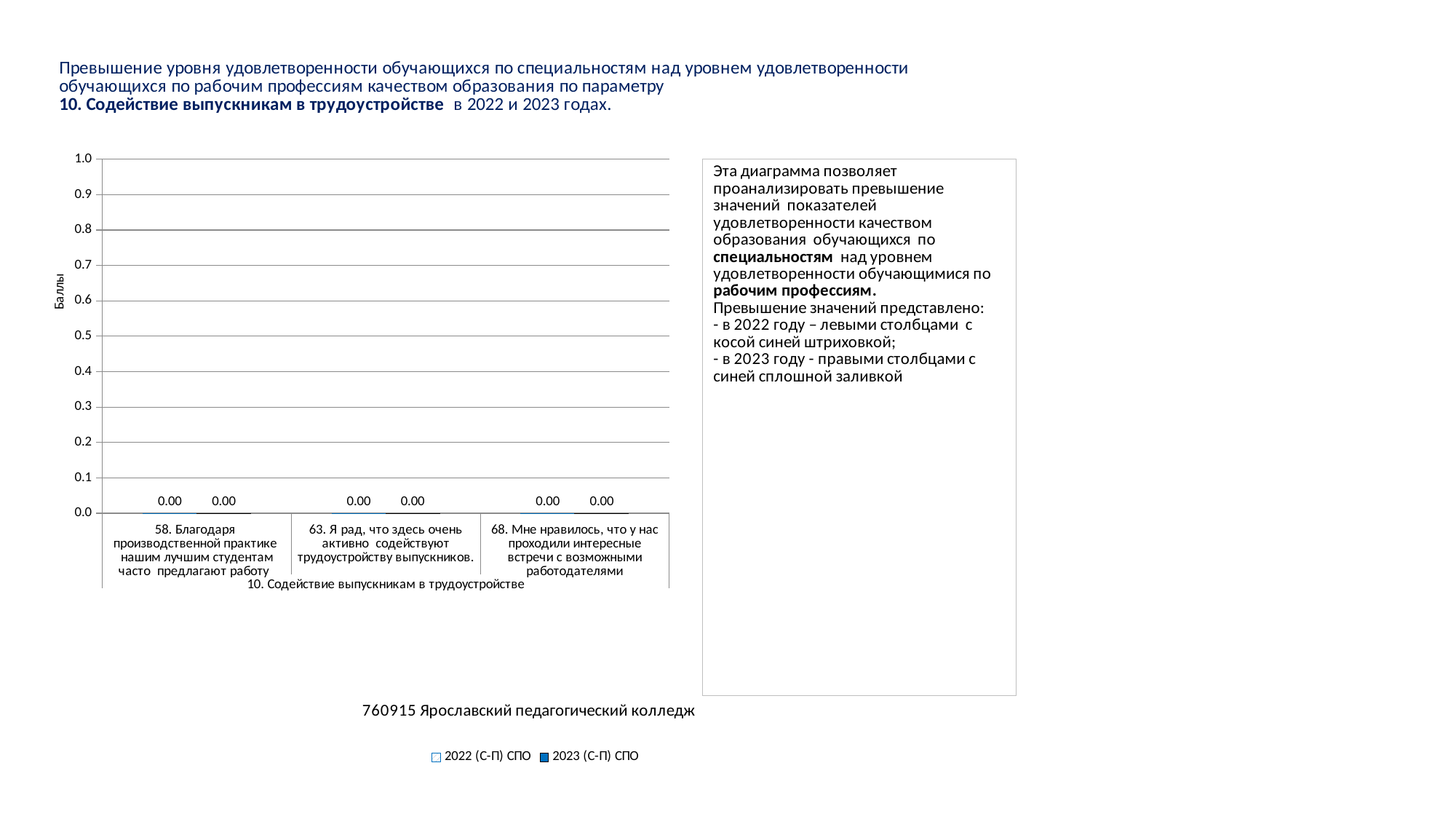
How many categories are shown on the x axis of the chart? 3 Is the value for the 2023 (С-П) СПО series for category 68 greater or less than 0.5? less What is the value for the 2023 (С-П) СПО series for category 58? 0.00 How many series does the chart legend list? 2 What is the value for the 2022 (С-П) СПО series for category 68 (Мне нравилось, что у нас проходили интересные встречи с возможными работодателями)? 0.00 What is the label of the vertical axis of the chart? Баллы What is the total of the 2022 (С-П) СПО values across all three categories? 0.00 What is the value for the 2022 (С-П) СПО series for category 58 (Благодаря производственной практике нашим лучшим студентам часто предлагают работу)? 0.00 What kind of chart is shown on the slide? bar chart What is the difference between the 2022 (С-П) СПО and 2023 (С-П) СПО values for category 63? 0.00 What is the value for the 2023 (С-П) СПО series for category 63 (Я рад, что здесь очень активно содействуют трудоустройству выпускников)? 0.00 What is the title shown below the chart? 760915 Ярославский педагогический колледж